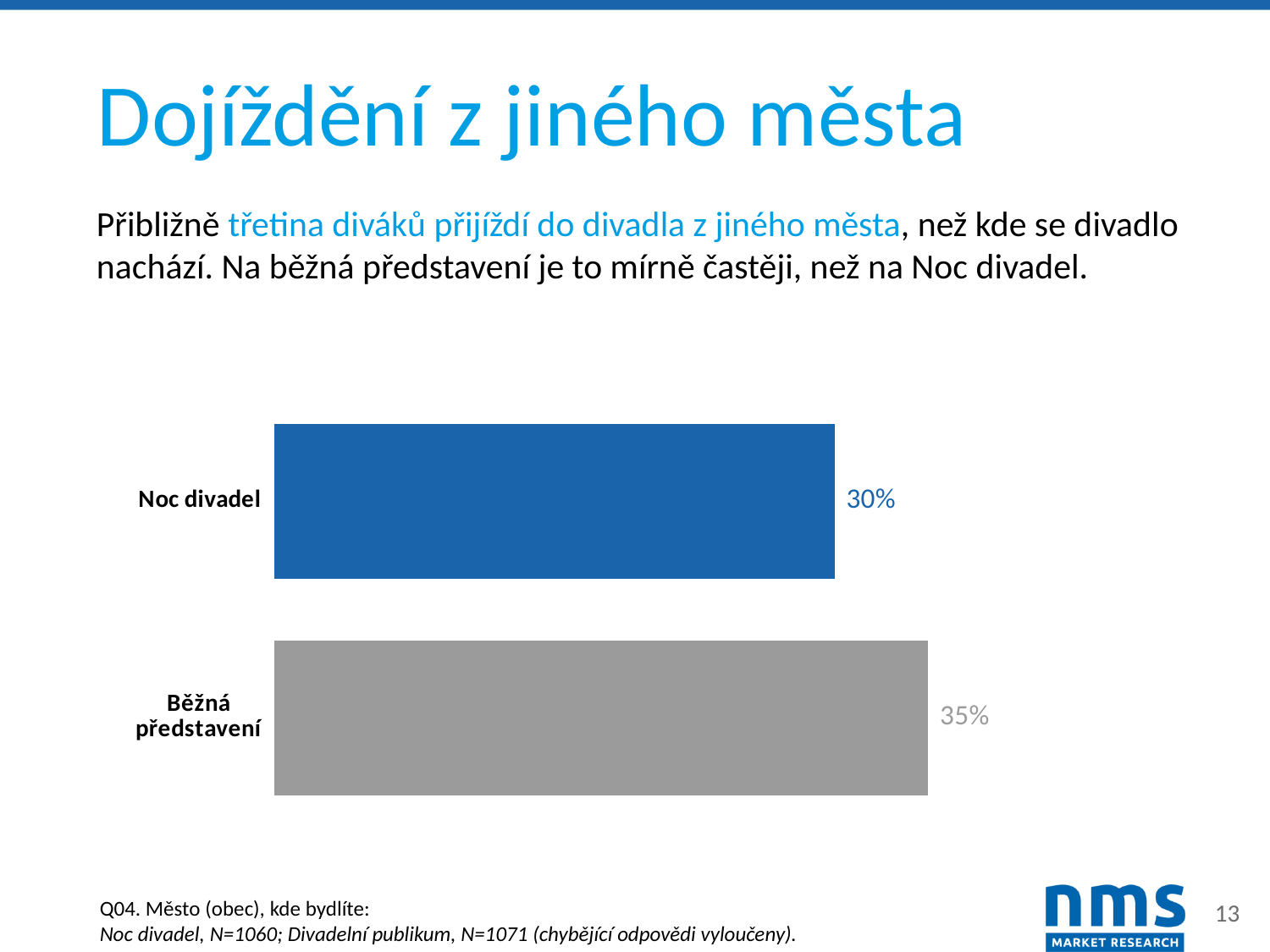
What is the difference between the values for Běžná představení and Noc divadel? 5 percentage points What colour is the bar for Noc divadel? blue Which category has the lower value? Noc divadel What is the value for Noc divadel? 30% What colour is the bar for Běžná představení? grey Is the value for Noc divadel larger or smaller than the value for Běžná představení? smaller Which category has the higher value? Běžná představení What kind of chart is shown on the slide? bar chart How many categories are shown in the chart? 2 What is the value for Běžná představení? 35%